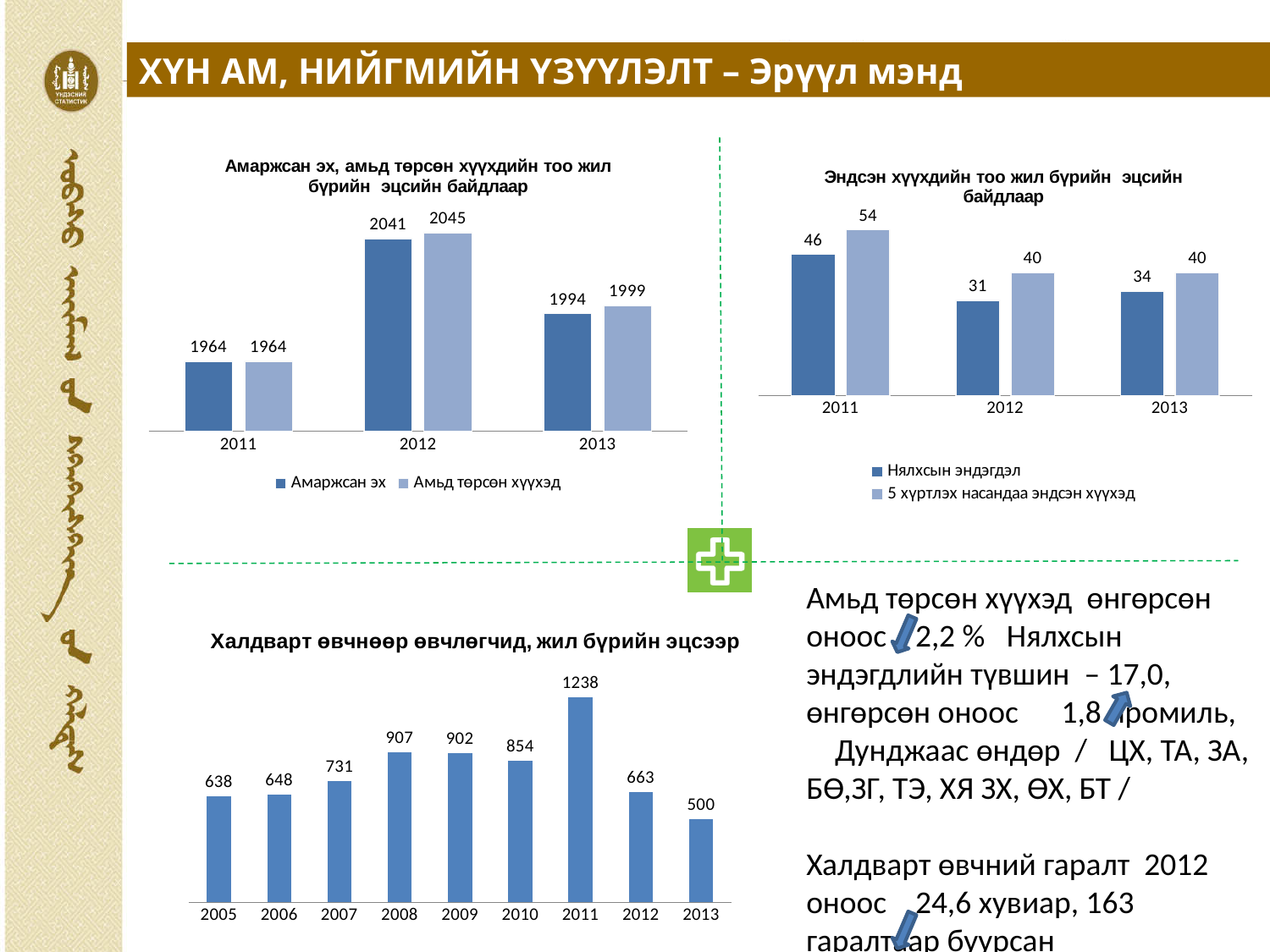
In the bottom-left chart (Халдварт өвчнөөр өвчлөгчид), what is the value for 2008? 907 In the top-right chart (Эндсэн хүүхдийн тоо), what is the difference between 5 хүртлэх насандаа эндсэн хүүхэд and Нялхсын эндэгдэл in 2013? 6 In the top-left chart (Амаржсан эх, амьд төрсөн хүүхдийн тоо), what is the value for Амаржсан эх in 2012? 2041 In the top-right chart (Эндсэн хүүхдийн тоо), which year has the lowest value for Нялхсын эндэгдэл? 2012 In the top-right chart (Эндсэн хүүхдийн тоо), what is the value for Нялхсын эндэгдэл in 2011? 46 In the bottom-left chart (Халдварт өвчнөөр өвчлөгчид), which year has the highest value? 2011 In the bottom-left chart (Халдварт өвчнөөр өвчлөгчид), how many years are shown on the x axis? 9 What kind of chart is the bottom-left chart (Халдварт өвчнөөр өвчлөгчид)? Bar chart In the top-left chart (Амаржсан эх, амьд төрсөн хүүхдийн тоо), what is the value for Амьд төрсөн хүүхэд in 2013? 1999 In the bottom-left chart (Халдварт өвчнөөр өвчлөгчид), what is the difference between the values for 2011 and 2012? 575 In the top-left chart (Амаржсан эх, амьд төрсөн хүүхдийн тоо), how many series does the legend list? 2 In the top-left chart (Амаржсан эх, амьд төрсөн хүүхдийн тоо), what is the difference between Амьд төрсөн хүүхэд and Амаржсан эх in 2012? 4